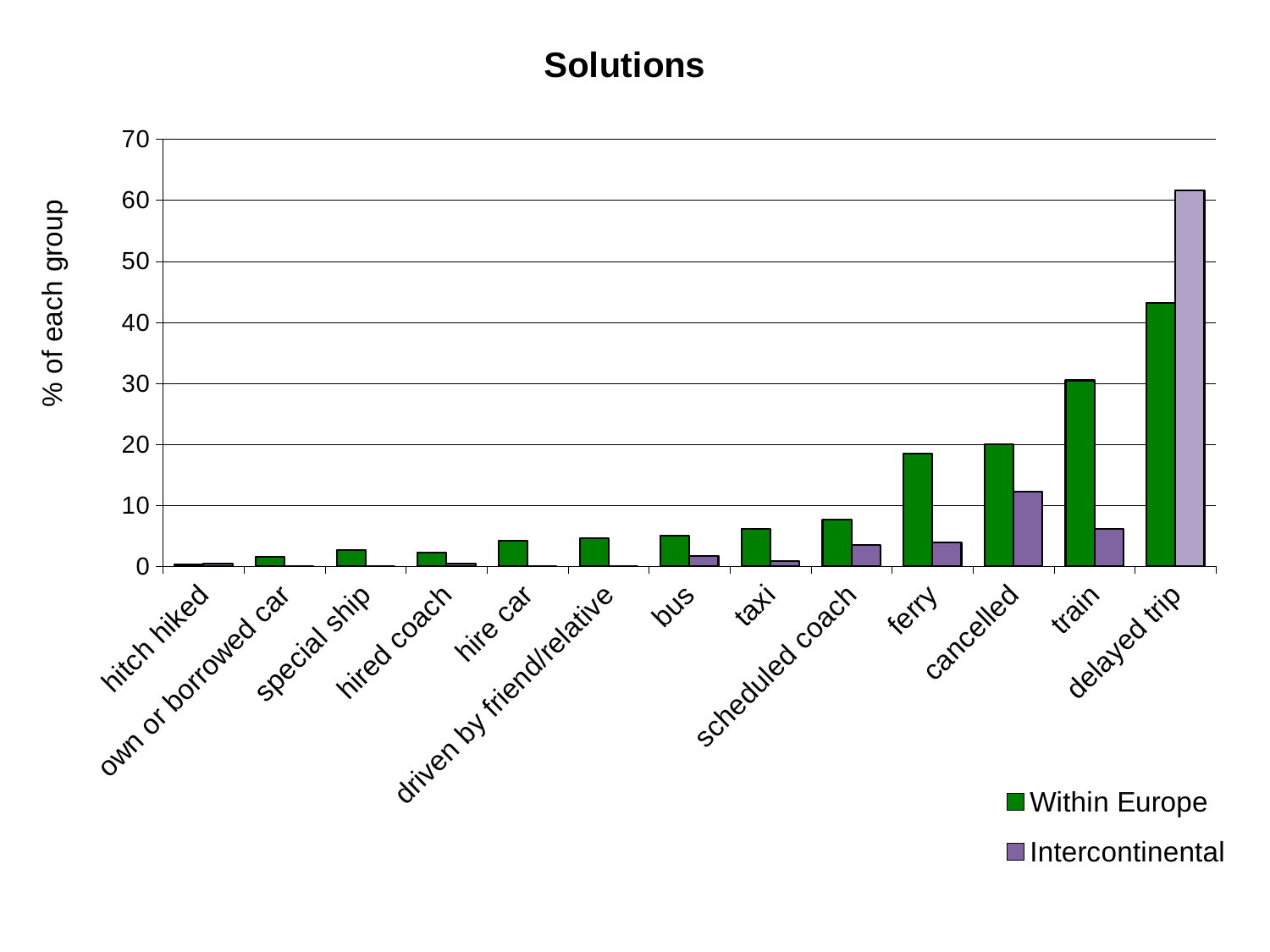
What kind of chart is shown on the slide? bar chart Which category has the lowest value for the Within Europe series? hitch hiked Is the Intercontinental value for delayed trip greater or less than 50? greater For train, which series has the larger value, Within Europe or Intercontinental? Within Europe Is the Intercontinental value for train greater or less than 10? less Which category has the highest value for the Within Europe series? delayed trip For delayed trip, which series has the larger value, Within Europe or Intercontinental? Intercontinental How many categories are shown on the x axis? 13 How many series does the legend list? 2 Which category has the highest value for the Intercontinental series? delayed trip Is the Within Europe value for ferry greater or less than 20? less